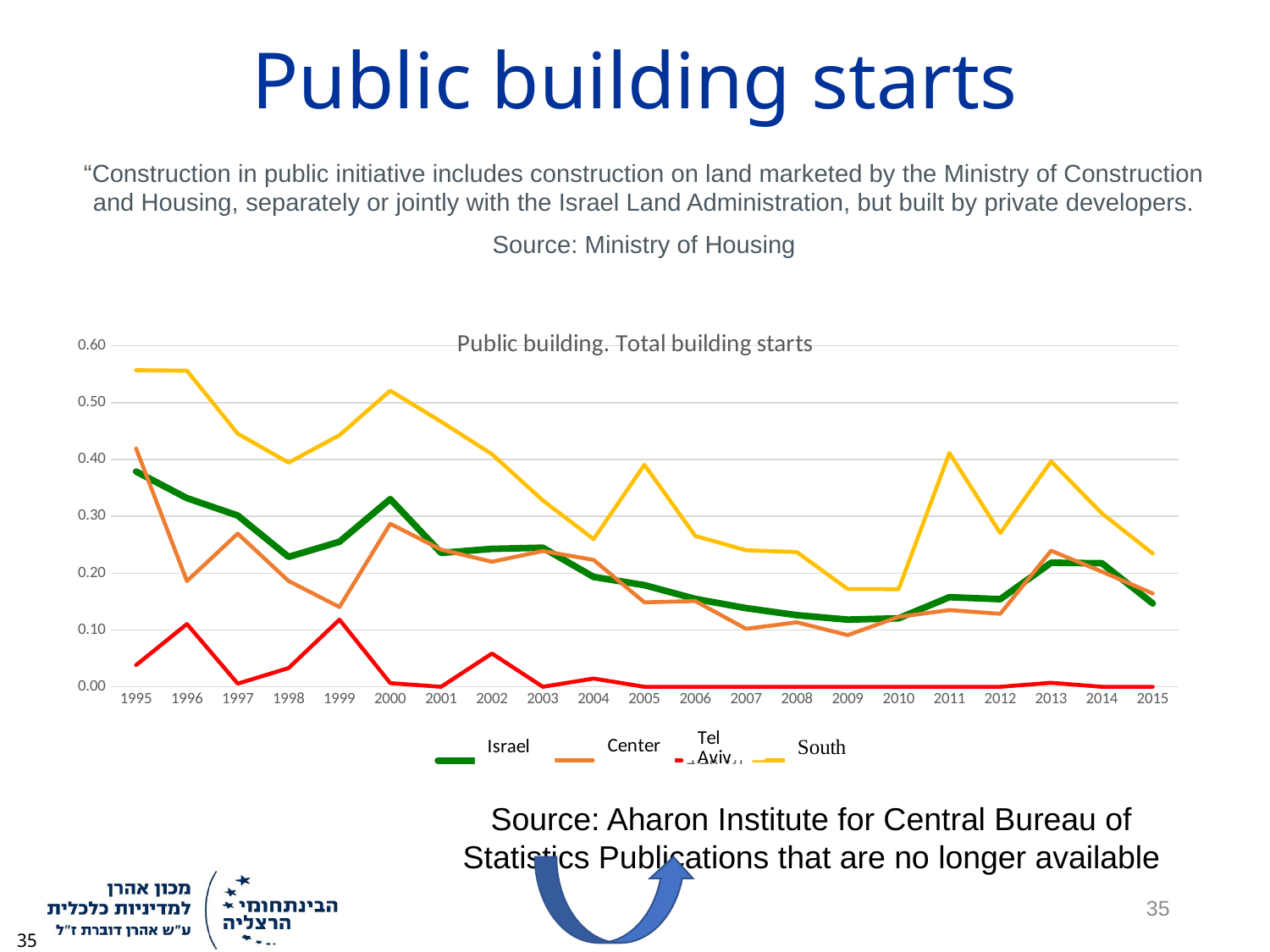
Is the value for Tel Aviv in 2002 greater or less than 0.10? less What kind of chart is shown on the slide? line chart What is the title of the chart? Public building. Total building starts Overall, does the Israel series rise or fall from 1995 to 2015? fall In 2011, which is larger: the value for South or the value for Israel? South How many years are shown along the x axis of the chart? 21 Is the value for South in 1995 greater or less than 0.50? greater Is the value for Israel in 2015 greater or less than 0.20? less How many series does the chart's legend list? 4 Which series has the highest value in 1995? South Which series has the lowest value in 2015? Tel Aviv